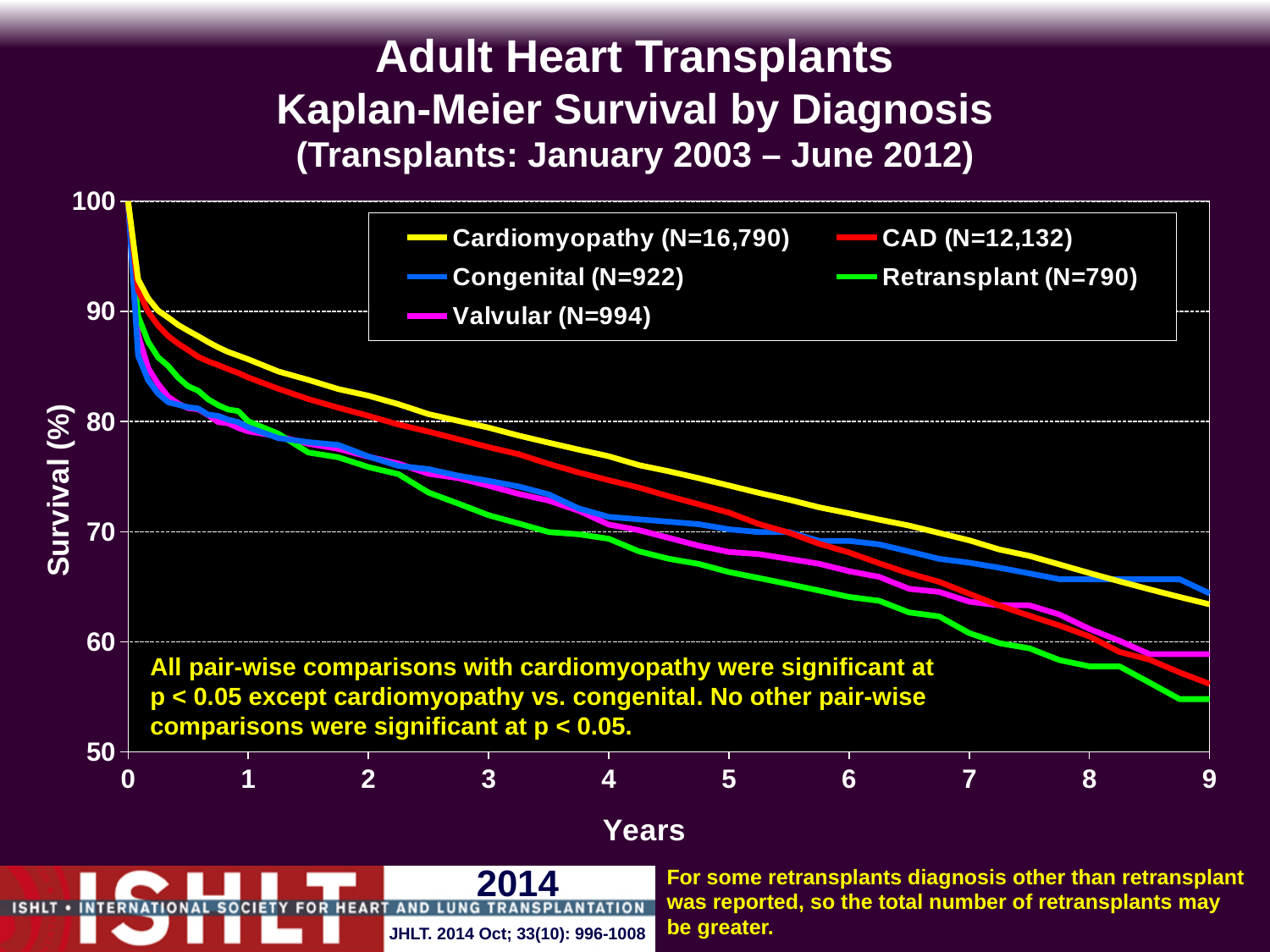
Is the survival value for Retransplant at 9 years greater or less than 60? less Do the survival curves rise or fall as years increase? fall Is the survival value for CAD at 3 years greater or less than 80? less According to the legend, what is the N for the Cardiomyopathy group? 16,790 How many series does the legend list? 5 What kind of chart is shown on the slide? line chart According to the legend, what is the N for the CAD group? 12,132 Which diagnosis group has the highest survival at 5 years? Cardiomyopathy At 7 years, which has higher survival: Cardiomyopathy or Retransplant? Cardiomyopathy According to the legend, what is the N for the Retransplant group? 790 Which colour is used for the Valvular series? magenta Is the survival value for Cardiomyopathy at 5 years greater or less than 70? greater